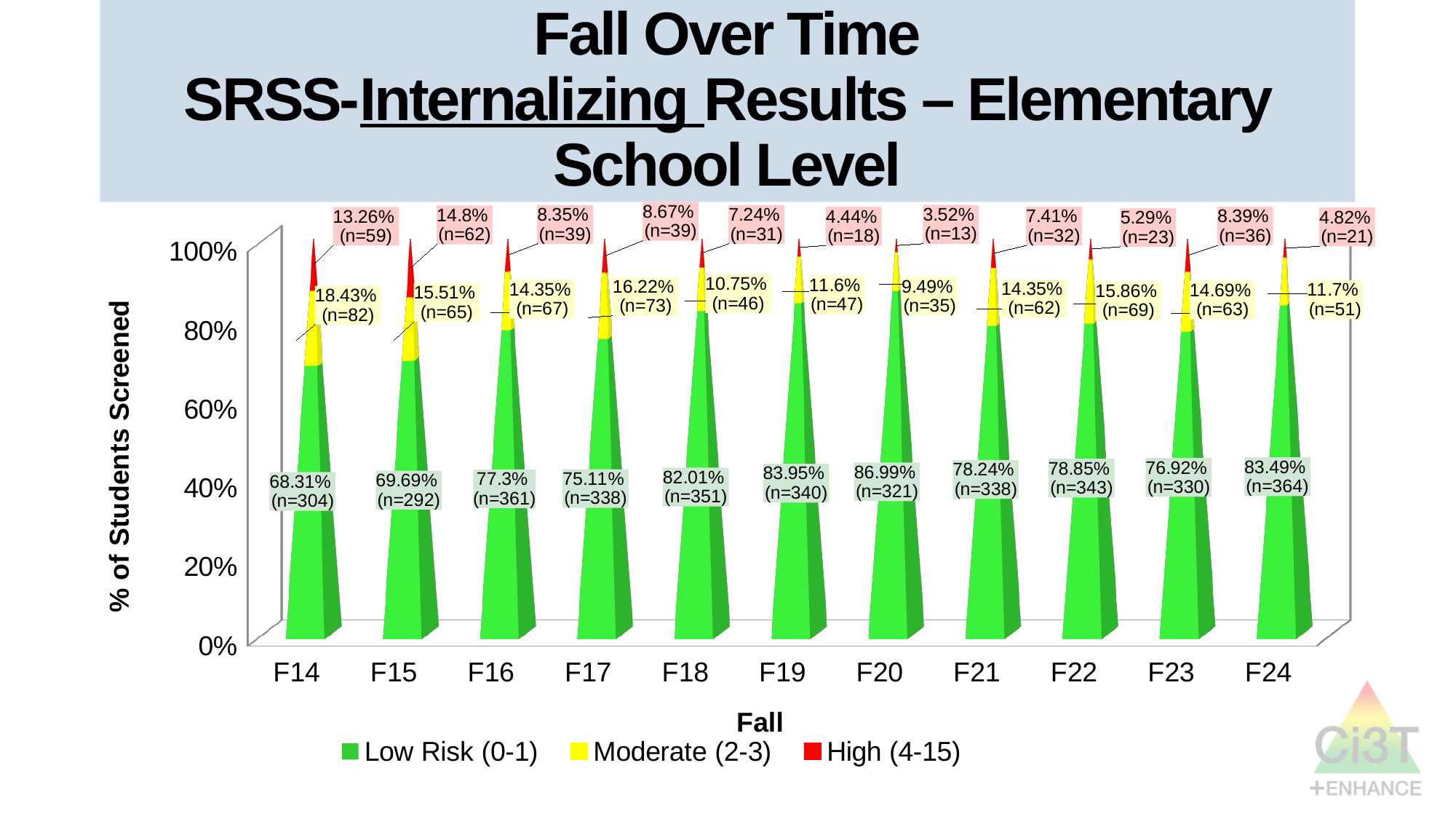
How many students were in the Moderate (2-3) category in F17? n=73 What colour represents the High (4-15) category in the legend? Red What percentage of students were in the High (4-15) category in F14? 13.26% Which fall has the lowest Low Risk (0-1) percentage? F14 Which fall has the highest Low Risk (0-1) percentage? F20 What percentage of students were Low Risk (0-1) in F20? 86.99% Which fall has the lowest High (4-15) percentage? F20 How many series does the legend list? 3 How many fall time points are shown on the x axis? 11 Which has a larger Low Risk (0-1) percentage, F17 or F18? F18 What kind of chart is shown? Stacked bar chart What is the difference in Low Risk (0-1) percentage between F20 and F14? 18.68 percentage points